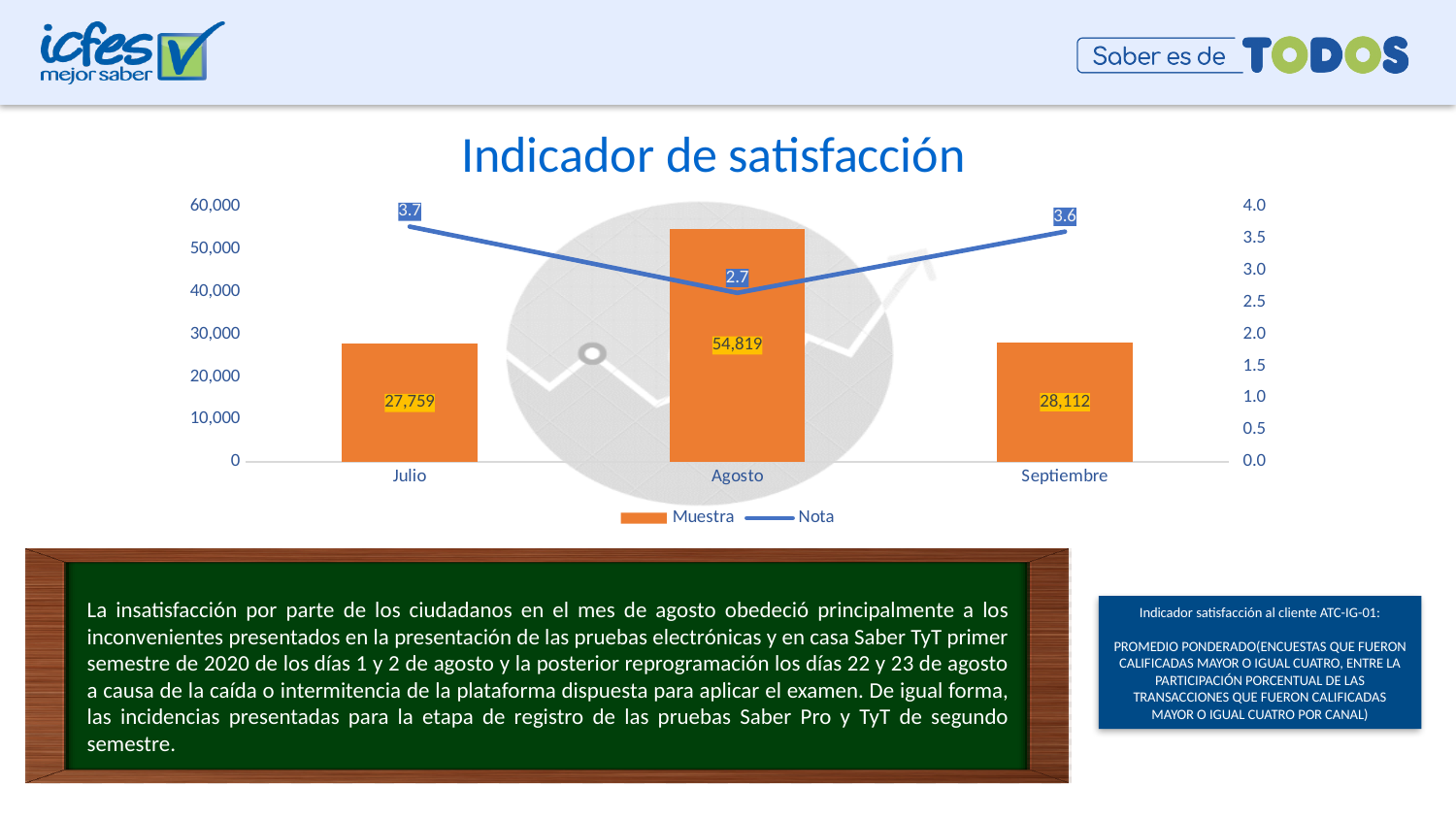
How many series does the legend list? 2 Which month has the lowest Nota value? Agosto What is the Muestra value for Agosto? 54,819 What is the Nota value for Agosto? 2.7 Which month has the highest Muestra value? Agosto What is the Nota value for Septiembre? 3.6 Which is larger, the Muestra value for Septiembre or for Julio? Septiembre What is the title of the chart? Indicador de satisfacción Does the Nota line rise or fall from Julio to Agosto? fall What is the Muestra value for Julio? 27,759 How many months are shown on the x axis? 3 What is the difference between the Muestra values for Agosto and Julio? 27,060